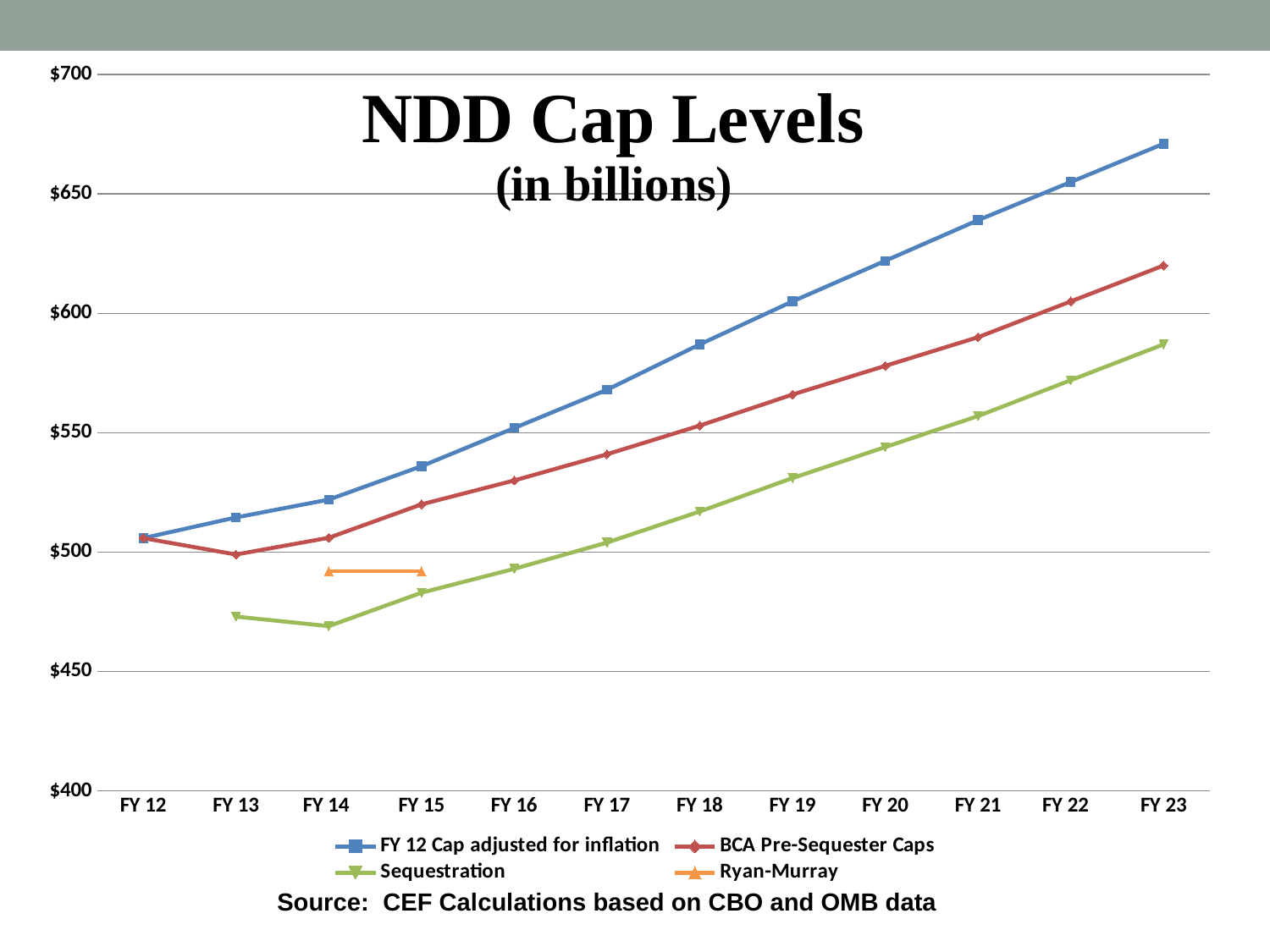
What is the title of the chart? NDD Cap Levels (in billions) How many fiscal years are shown on the x axis? 12 Is the value for FY 12 Cap adjusted for inflation in FY 23 greater or less than $650? greater In FY 20, which is larger: FY 12 Cap adjusted for inflation or BCA Pre-Sequester Caps? FY 12 Cap adjusted for inflation How many series does the legend list? 4 What kind of chart is shown on the slide? Line chart Which series has the highest value in FY 23? FY 12 Cap adjusted for inflation Is the value for BCA Pre-Sequester Caps in FY 23 greater or less than $600? greater Which series has the lowest value in FY 14? Sequestration Is the value for Sequestration in FY 14 greater or less than $500? less Does the FY 12 Cap adjusted for inflation line rise or fall from FY 12 to FY 23? Rises